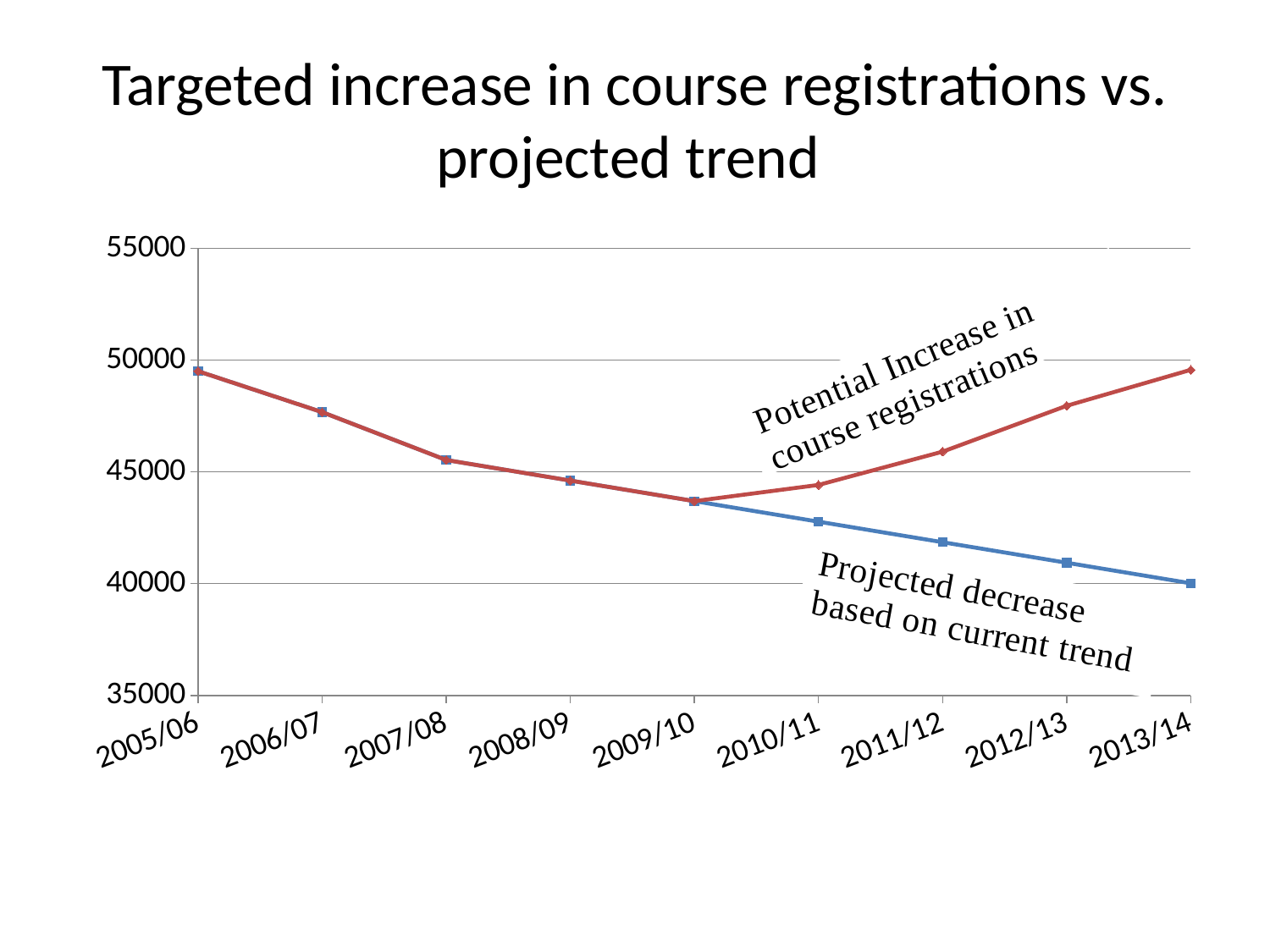
At 2013/14, which line has the larger value, 'Potential Increase in course registrations' or 'Projected decrease based on current trend'? Potential Increase in course registrations Is the value of the 'Potential Increase in course registrations' line for 2013/14 greater or less than 45000? greater Does the 'Potential Increase in course registrations' line rise or fall from 2009/10 to 2013/14? rise Do the values rise or fall from 2005/06 to 2009/10? fall What kind of chart is shown on the slide? line chart Is the value of the 'Projected decrease based on current trend' line for 2011/12 greater or less than 40000? greater What is the title of the chart on the slide? Targeted increase in course registrations vs. projected trend Is the value for 2009/10 greater or less than 45000? less How many academic years are shown along the x axis? 9 How many lines are plotted on the chart? 2 What label is given to the blue line? Projected decrease based on current trend